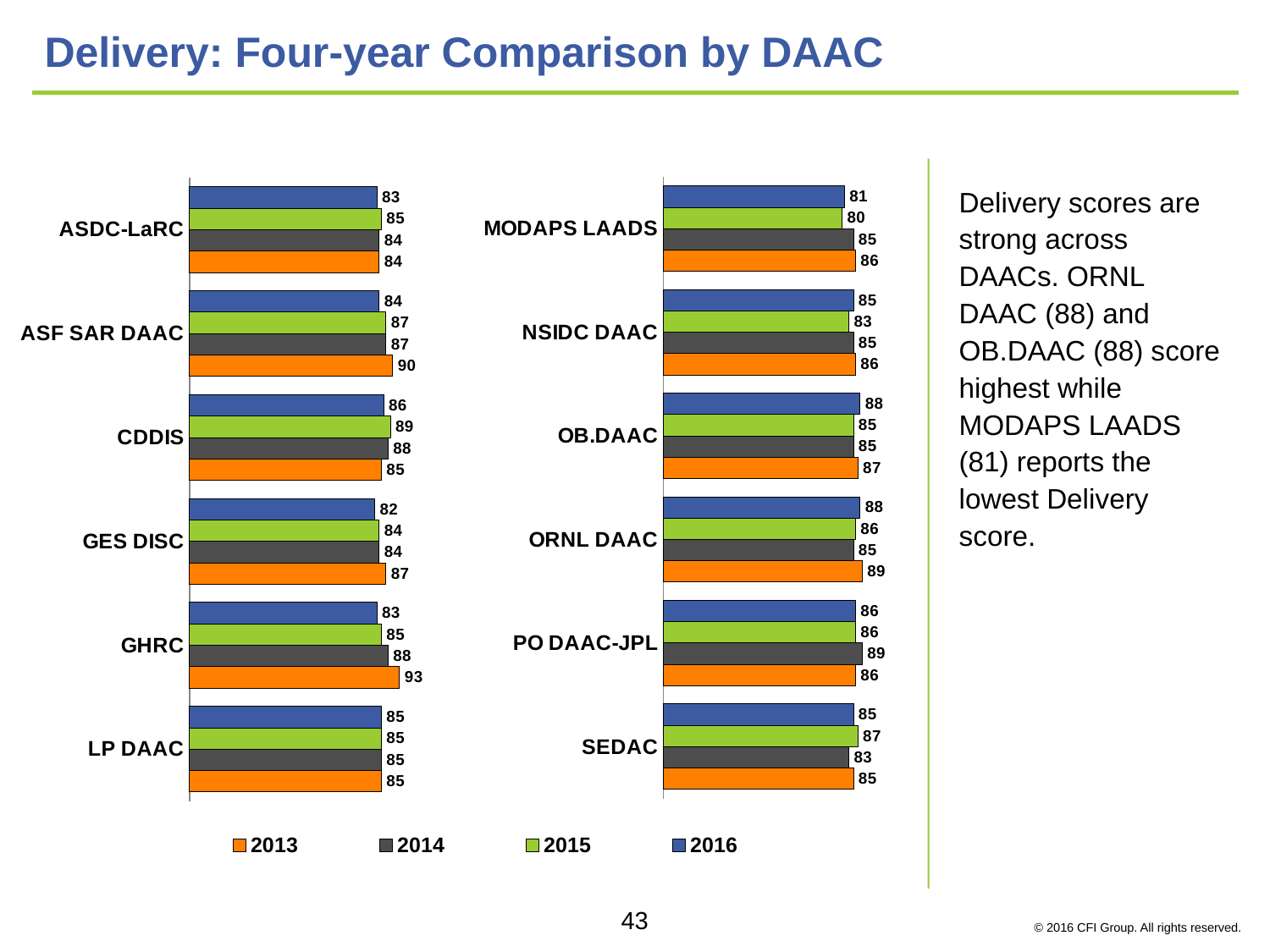
Which colour represents 2015 in the legend? Green On the right chart, what is the 2014 value for PO DAAC-JPL? 89 On the left chart, which DAAC has the highest 2013 value? GHRC How many series does the legend list? 4 On the right chart, which DAAC has the lowest 2015 value? MODAPS LAADS On the right chart, which is larger for ORNL DAAC: the 2013 value or the 2014 value? 2013 On the left chart, what is the 2015 value for CDDIS? 89 What kind of chart is used on this slide? Bar chart On the left chart, what is the difference between the 2013 and 2016 values for ASF SAR DAAC? 6 On the left chart, what is the 2013 value for GHRC? 93 On the right chart, what is the 2016 value for MODAPS LAADS? 81 How many DAACs are shown on the left chart? 6